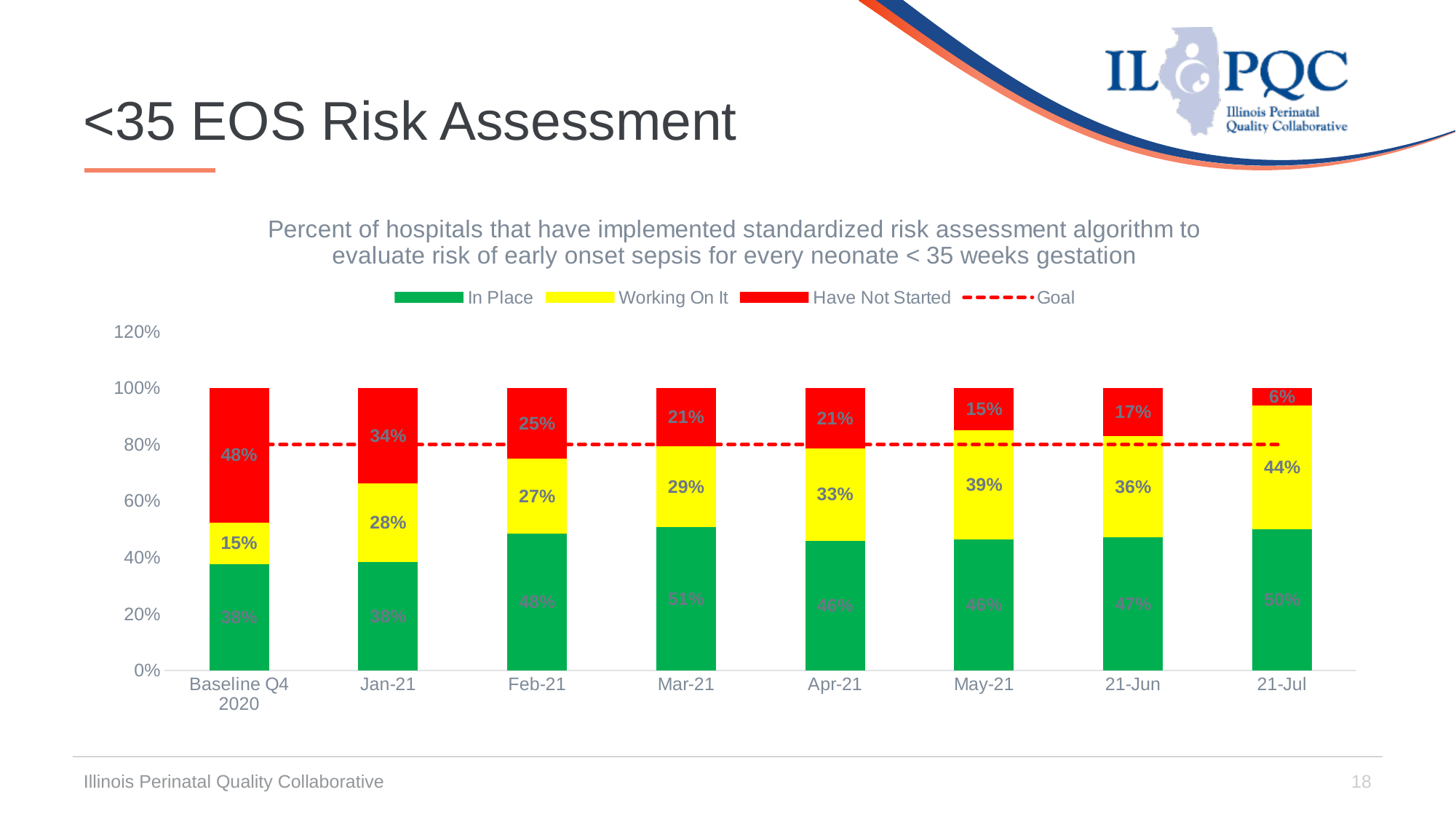
Which is larger, the Working On It value for May-21 or for 21-Jun? May-21 What colour represents the In Place series? Green How many entries does the legend list? 4 Does the Have Not Started value generally rise or fall from Baseline Q4 2020 to 21-Jul? Fall What is the Have Not Started value for Baseline Q4 2020? 48% How many periods are shown on the x axis? 8 Which period has the lowest Have Not Started value? 21-Jul What is the In Place value for Mar-21? 51% What is the difference between the Have Not Started value for Baseline Q4 2020 and for 21-Jul? 42% What kind of chart is shown on the slide? Stacked bar chart What is the Working On It value for 21-Jul? 44% Which period has the highest In Place value? Mar-21